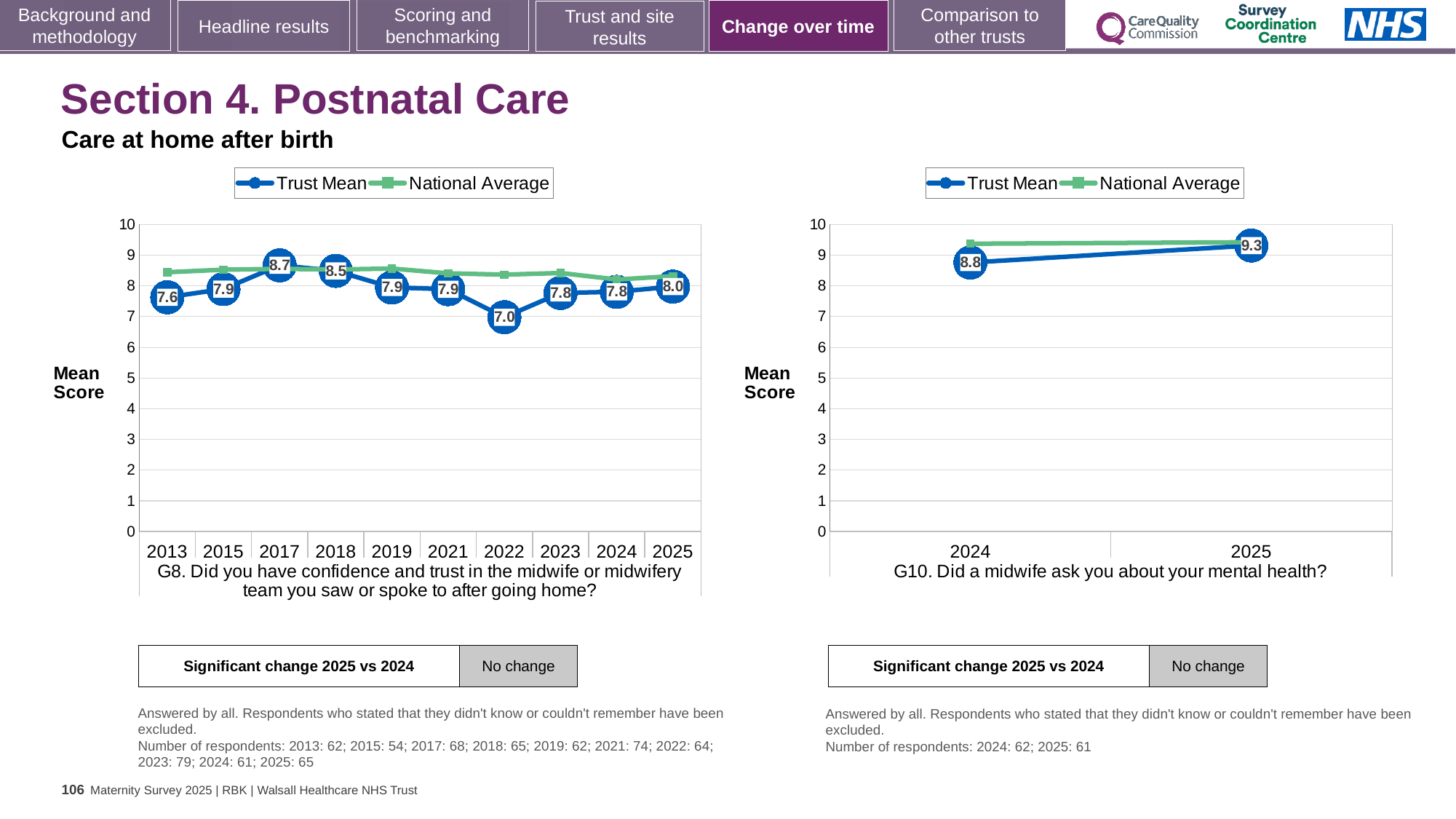
In the G8 chart, what is the Trust Mean score for 2017? 8.7 In the G10 chart, what is the Trust Mean score for 2025? 9.3 In the G8 chart, how many years are shown on the x axis? 10 In the G8 chart, what is the Trust Mean score for 2022? 7.0 In the G8 chart, is the National Average for 2022 greater or less than 8? greater What kind of chart is the G8 chart? line chart In the G10 chart, does the Trust Mean rise or fall from 2024 to 2025? rise In the G8 chart, which year has the highest Trust Mean score? 2017 In the G8 chart, which year has the lowest Trust Mean score? 2022 In the G8 chart, what is the difference between the Trust Mean scores for 2017 and 2022? 1.7 In the G10 chart, what is the difference between the Trust Mean scores for 2025 and 2024? 0.5 How many series does the legend of the G10 chart list? 2